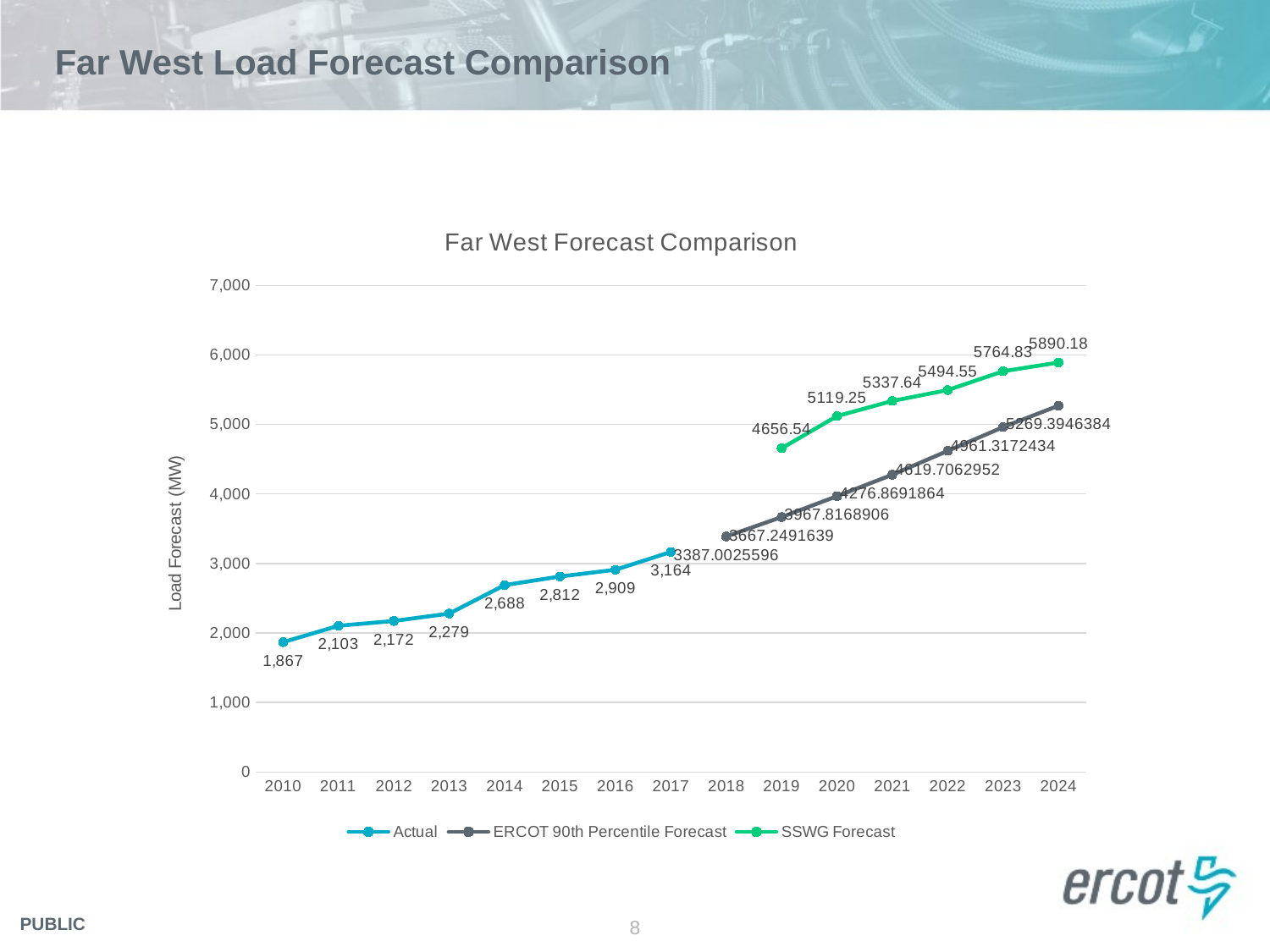
In which year is the Actual series at its lowest? 2010 What is the title of the vertical axis? Load Forecast (MW) What is the Actual load value for 2010? 1,867 What is the SSWG Forecast value for 2019? 4656.54 Does the Actual series rise or fall from 2010 to 2017? Rise For 2024, which is larger: the SSWG Forecast or the ERCOT 90th Percentile Forecast? SSWG Forecast What is the SSWG Forecast value for 2024? 5890.18 What is the Actual load value for 2017? 3,164 In which year is the Actual series at its highest? 2017 What kind of chart is shown on the slide? Line chart How many series does the legend list? 3 What is the difference between the Actual values for 2017 and 2010? 1,297